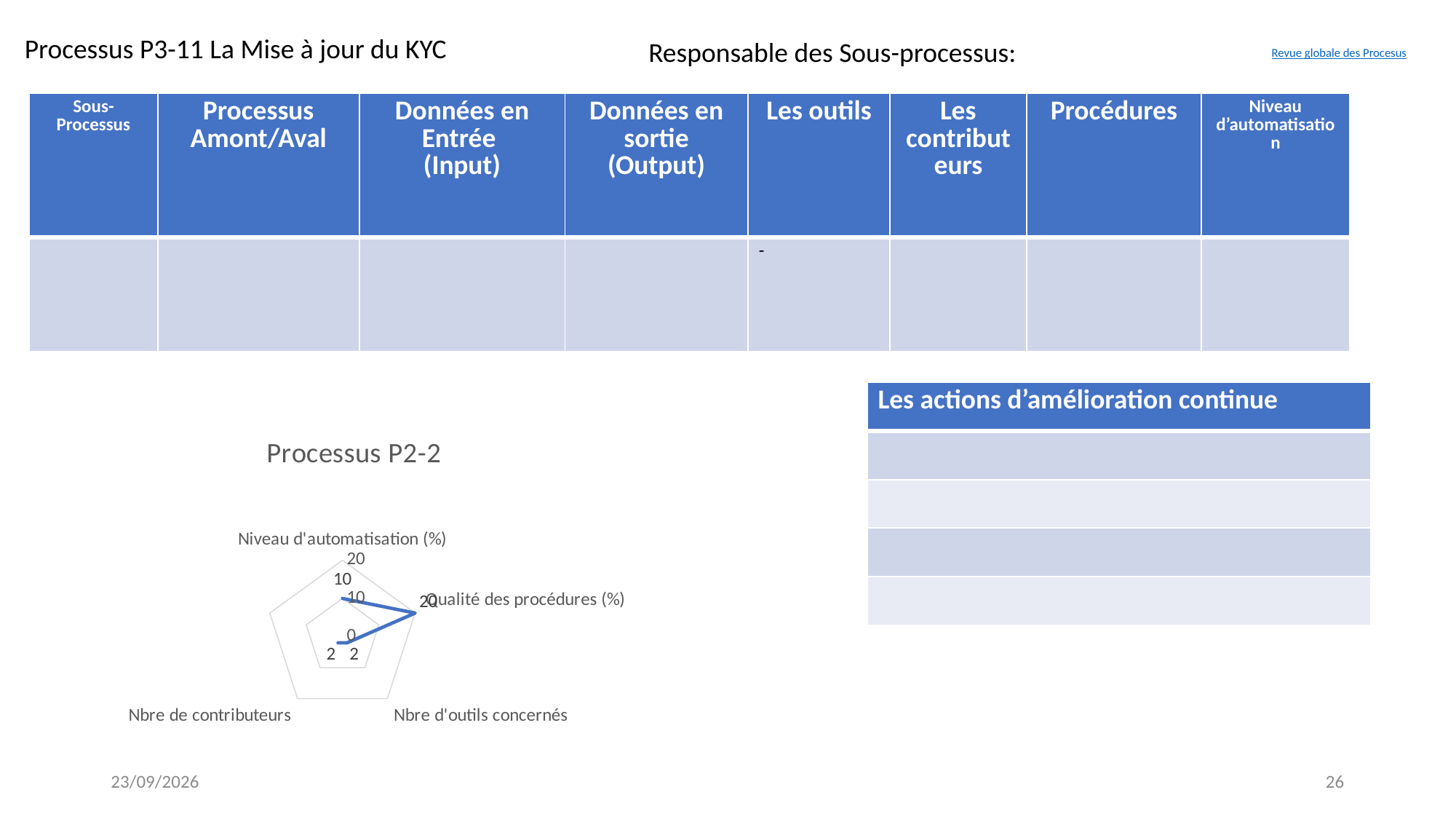
What is the highest tick value shown on the chart's axis? 20 What is the title of the chart? Processus P2-2 Is the value for Qualité des procédures (%) greater or less than 10? greater What is the difference between the values for Qualité des procédures (%) and Niveau d'automatisation (%)? 10 What is the value for Nbre d'outils concernés? 2 How many axes does the radar chart have? 5 Which is larger, the value for Niveau d'automatisation (%) or the value for Nbre d'outils concernés? Niveau d'automatisation (%) What is the value for Niveau d'automatisation (%)? 10 What is the value for Qualité des procédures (%)? 20 Which category has the highest value? Qualité des procédures (%) What kind of chart is shown on the slide? radar chart What is the value for Nbre de contributeurs? 2